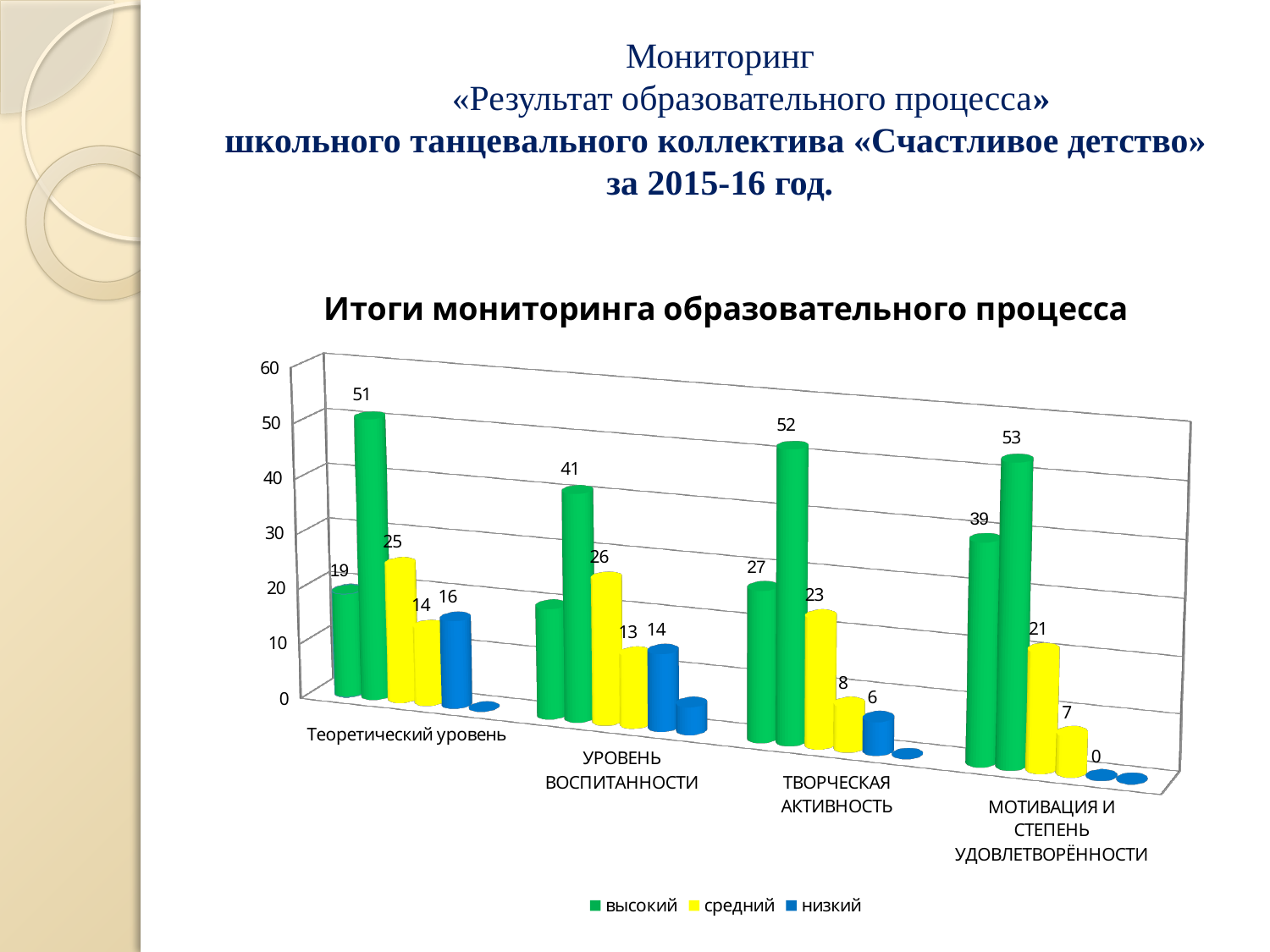
What is the highest value labelled anywhere on the chart? 53 What are the series names listed in the legend? высокий, средний, низкий How many categories are shown on the x axis of the chart? 4 What is the title of the chart? Итоги мониторинга образовательного процесса What value is labelled on the tallest bar in the Теоретический уровень group? 51 What is the lowest value labelled anywhere on the chart? 0 What value is labelled on the tallest bar in the Уровень воспитанности group? 41 Is the tallest bar in the Уровень воспитанности group greater or less than 30? greater What kind of chart is shown on the slide? bar chart What value is labelled on the tallest bar in the Творческая активность group? 52 What value is labelled on the tallest bar in the Мотивация и степень удовлетворённости group? 53 How many series does the chart legend list? 3